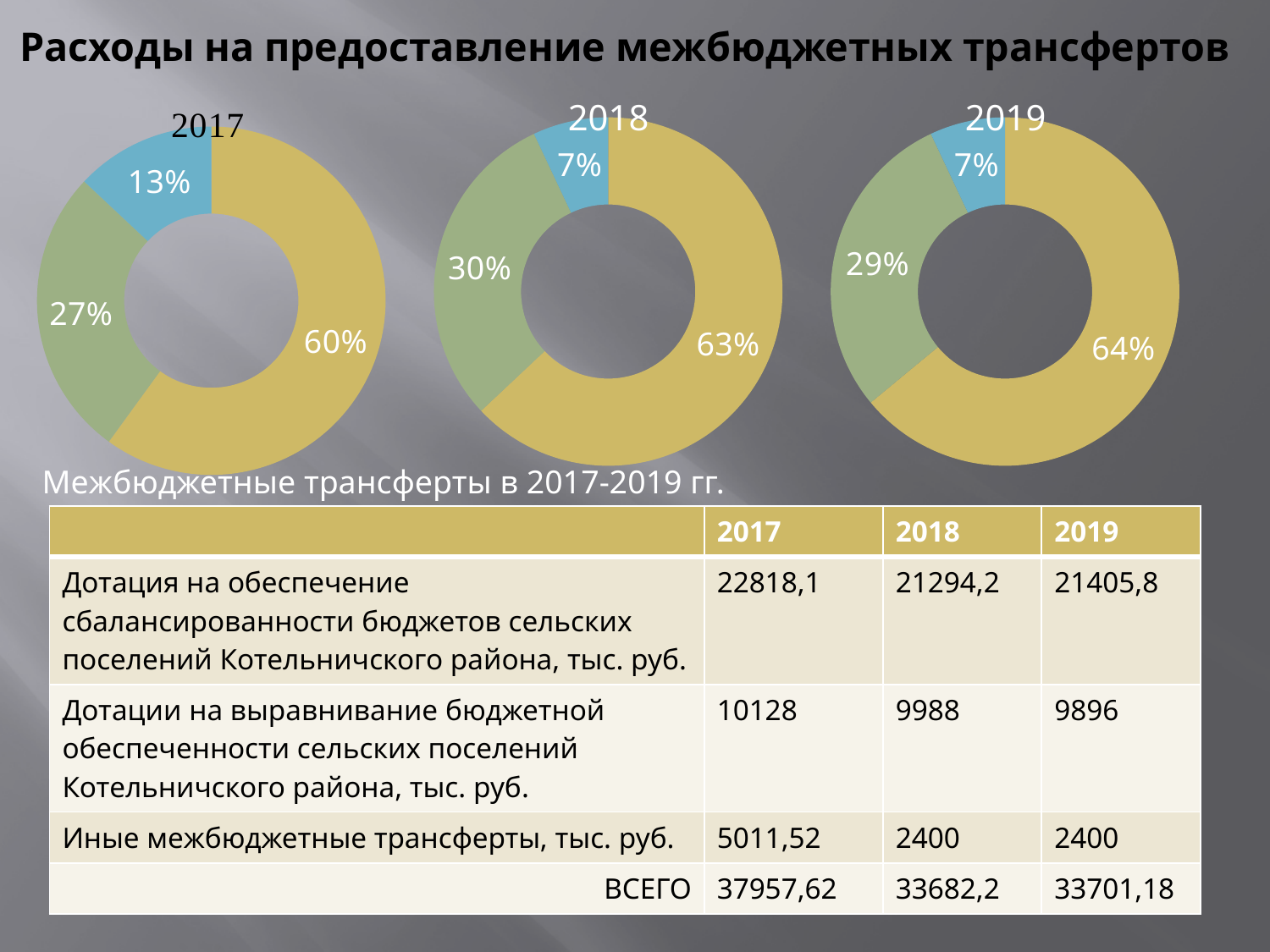
In the 2019 chart, what percentage is shown on the green slice? 29% Does the share of the yellow slice rise or fall from the 2017 chart to the 2019 chart? Rise In the 2017 chart, what percentage is shown on the blue slice? 13% In the 2019 chart, what percentage is shown on the smallest (blue) slice? 7% By how many percentage points does the yellow slice in the 2019 chart exceed the yellow slice in the 2017 chart? 4 In the 2017 chart, what percentage is shown on the green slice? 27% In the 2018 chart, what percentage is shown on the largest (yellow) slice? 63% How many slices does each pie chart contain? 3 How many pie charts are shown on the slide? 3 Which chart has the larger blue slice, 2017 or 2018? 2017 What is the title of the slide above the charts? Расходы на предоставление межбюджетных трансфертов What kind of chart is used for the 2017, 2018 and 2019 data on this slide? Pie (donut) chart